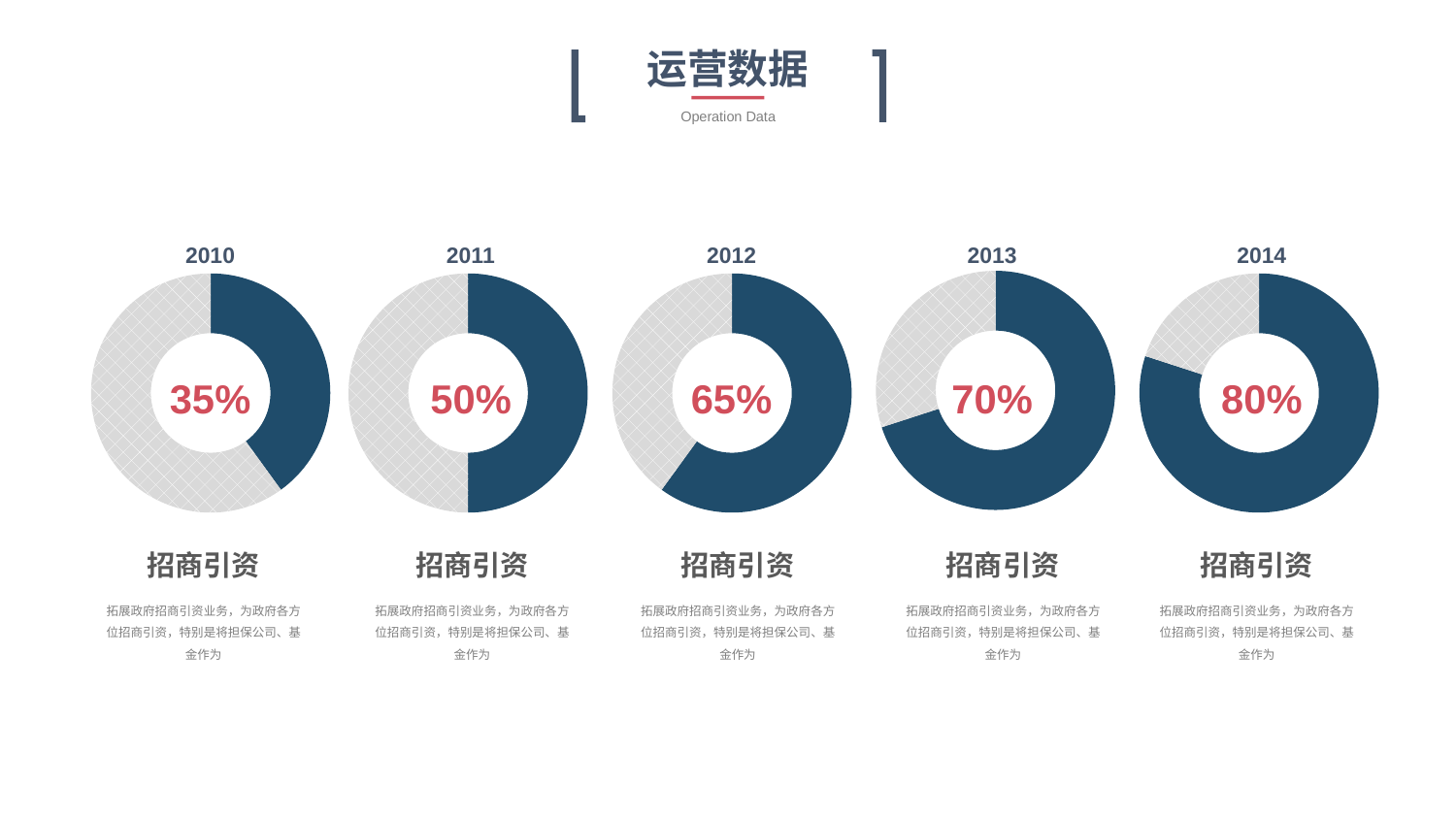
In the 2012 donut chart, what percentage is shown in the centre? 65% Do the percentages shown in the donut charts rise or fall from 2010 to 2014? Rise In the 2010 donut chart, what percentage is shown in the centre? 35% In the 2011 donut chart, what percentage is shown in the centre? 50% What is the difference between the percentage in the 2014 donut chart and the percentage in the 2010 donut chart? 45% Which is larger, the percentage in the 2012 donut chart or the percentage in the 2013 donut chart? 2013 What kind of chart is used for each year on the slide? Donut chart How many donut charts are shown on the slide? 5 Across the five donut charts, which year shows the lowest percentage? 2010 In the 2014 donut chart, what percentage is shown in the centre? 80% In the 2013 donut chart, what percentage is shown in the centre? 70% Across the five donut charts, which year shows the highest percentage? 2014